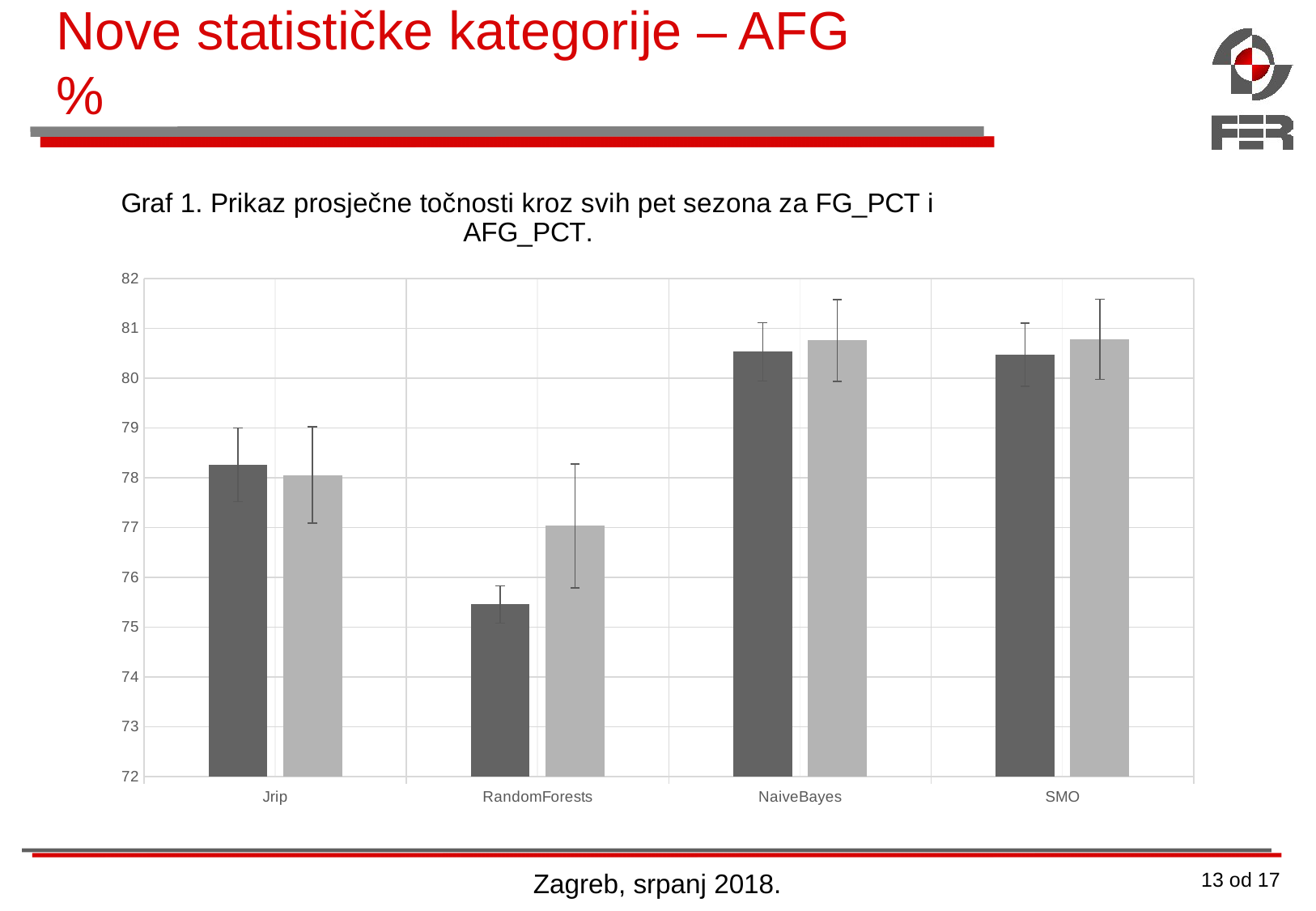
Is the dark grey bar for RandomForests greater or less than 76? less Is the dark grey bar for Jrip greater or less than 79? less Is the light grey bar for SMO greater or less than 81? less Which dark grey bar is taller, Jrip or RandomForests? Jrip What is the lowest value shown on the y axis of the chart? 72 How many categories are shown on the x axis of the chart? 4 For RandomForests, which bar is taller, the dark grey or the light grey one? light grey Which category has the lowest light grey bar? RandomForests What kind of chart is shown on the slide? bar chart Which category has the lowest dark grey bar? RandomForests What is the title of the chart? Graf 1. Prikaz prosječne točnosti kroz svih pet sezona za FG_PCT i AFG_PCT.